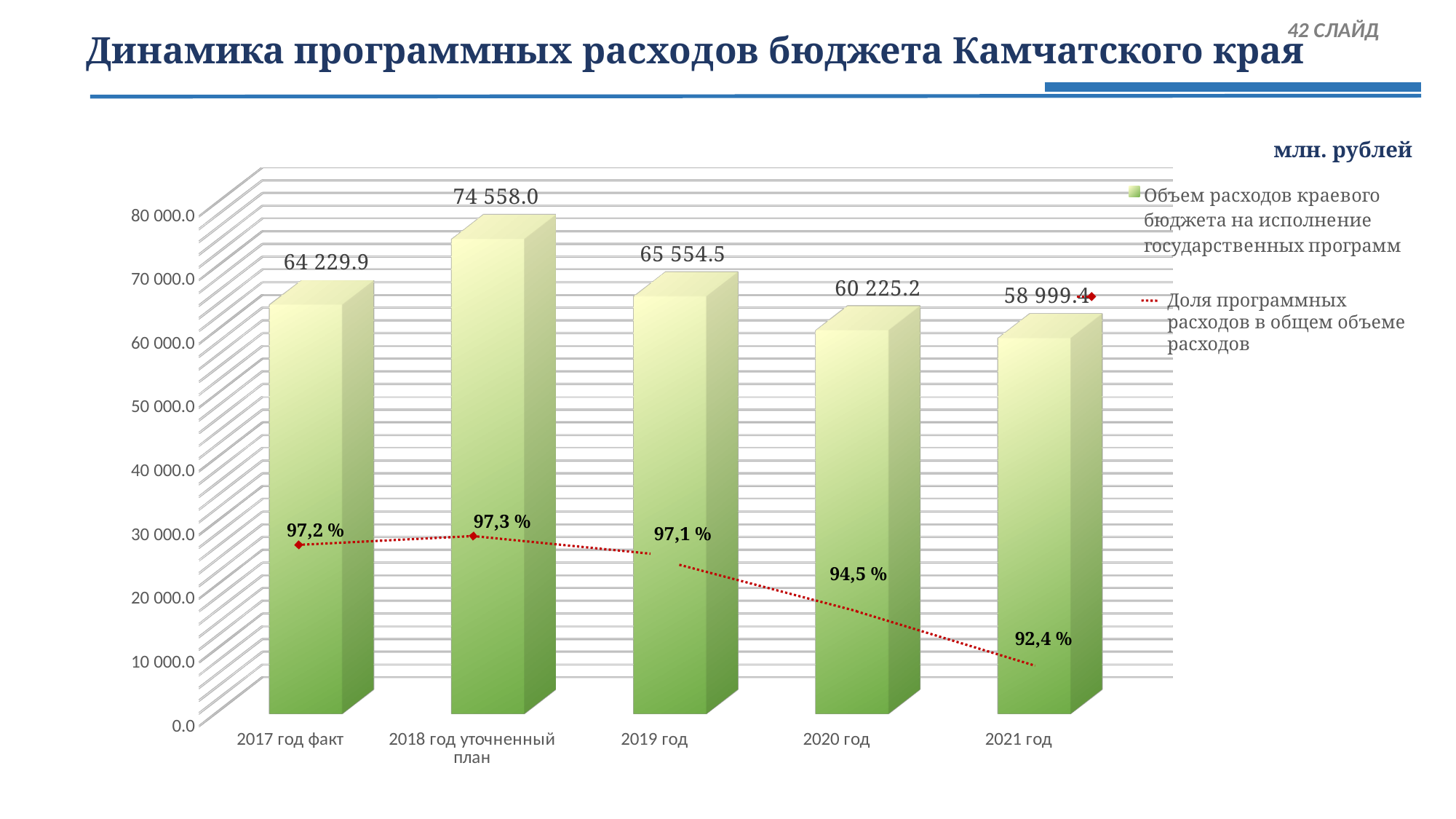
What is the value of the bar for 2018 год уточненный план? 74 558.0 How many categories are shown on the x axis? 5 What share of programme expenditure (Доля программных расходов) is shown for 2020 год? 94,5 % How does the share of programme expenditure (dotted line) change from 2019 год to 2021 год? It falls What is the value of the bar for 2021 год? 58 999.4 Which category has the lowest bar value? 2021 год What is the difference between the bar values for 2019 год and 2020 год? 5 329.3 What is the difference between the bar values for 2018 год уточненный план and 2017 год факт? 10 328.1 Which category has the highest bar value? 2018 год уточненный план What share of programme expenditure is shown for 2017 год факт? 97,2 % Which is larger, the bar value for 2019 год or for 2017 год факт? 2019 год How many series does the legend list? 2